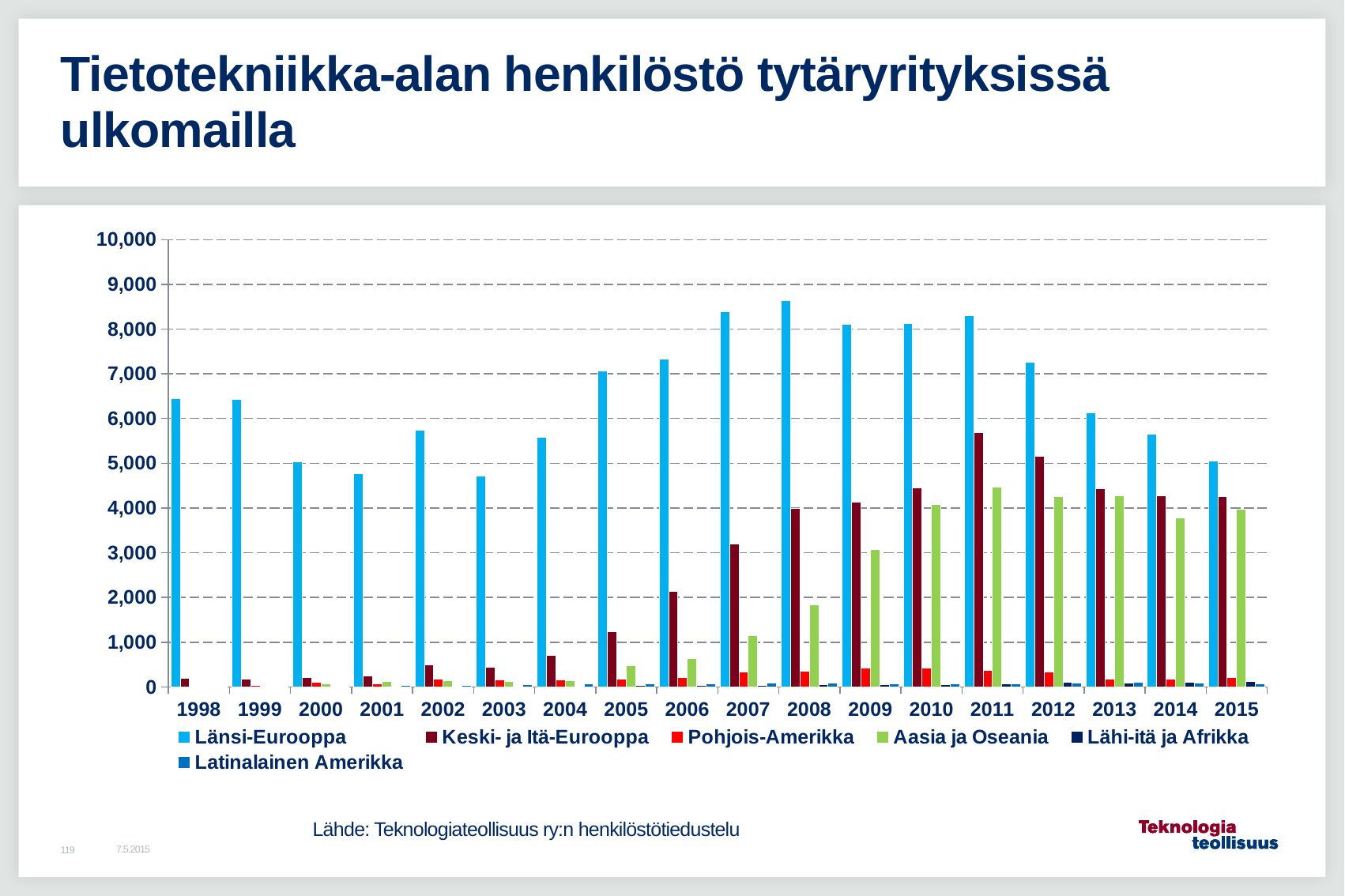
Which series is shown in light green in the legend? Aasia ja Oseania Does the Länsi-Eurooppa value rise or fall from 2011 to 2015? fall In which year is the Keski- ja Itä-Eurooppa value highest? 2011 Is the value for Keski- ja Itä-Eurooppa in 2011 greater or less than 5,000? greater Is the value for Aasia ja Oseania in 2008 greater or less than 2,000? less In which year is the Länsi-Eurooppa value highest? 2008 In 2012, which is larger: Keski- ja Itä-Eurooppa or Aasia ja Oseania? Keski- ja Itä-Eurooppa Is the value for Länsi-Eurooppa in 2003 greater or less than 5,000? less What kind of chart is shown on the slide? bar chart How many years are shown on the x axis? 18 How many series does the legend list? 6